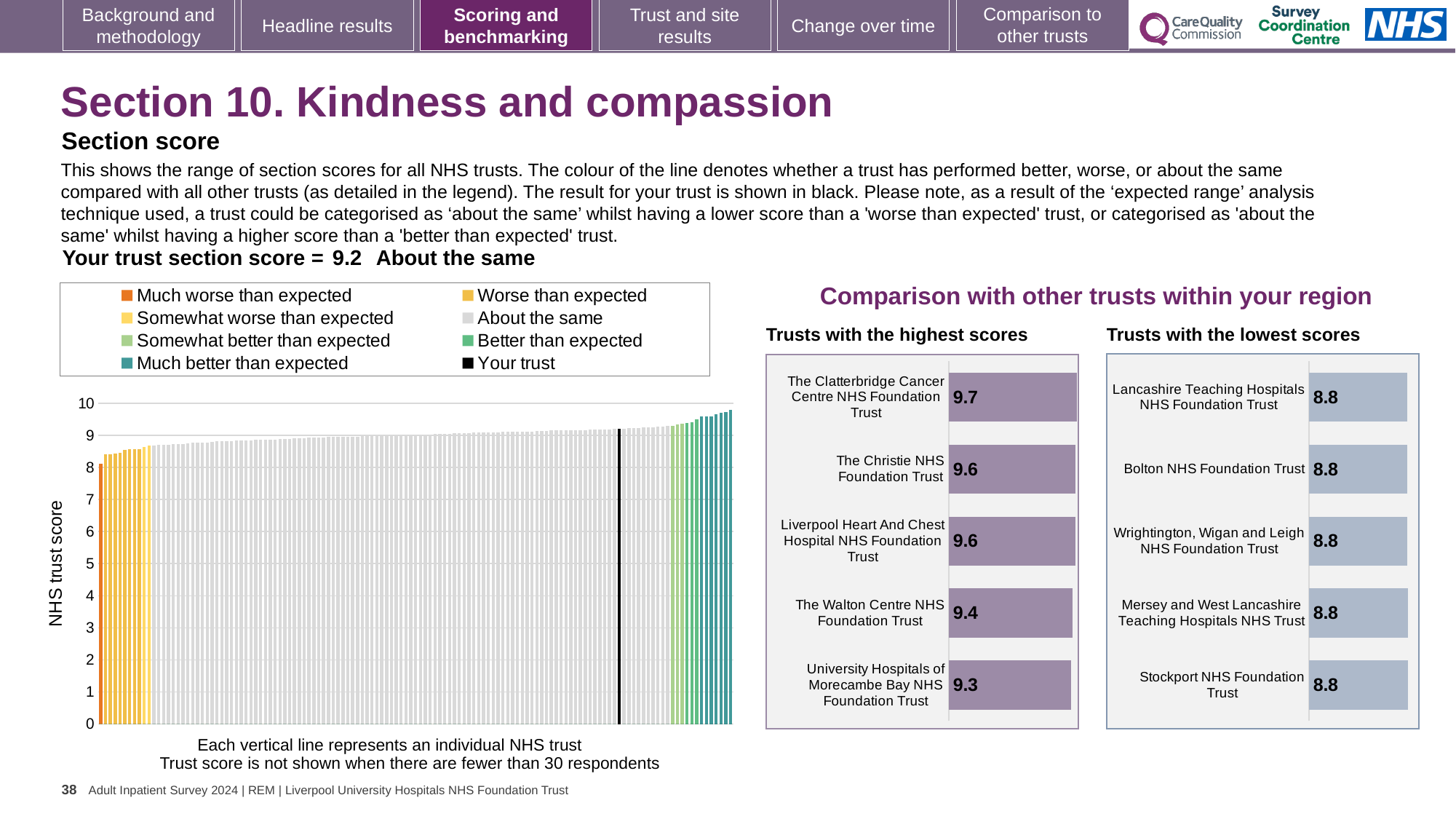
In the large chart on the left, is the value of the leftmost (orange) bar greater or less than 9? less In the 'Trusts with the lowest scores' chart, what is the score for Stockport NHS Foundation Trust? 8.8 How many entries does the legend above the large chart on the left list? 8 In the large chart on the left, what is the label on the vertical axis? NHS trust score In the 'Trusts with the highest scores' chart, what is the score for The Walton Centre NHS Foundation Trust? 9.4 In the large chart on the left, do the trust scores rise or fall from left to right? rise In the 'Trusts with the highest scores' chart, what is the difference between the scores of The Clatterbridge Cancer Centre NHS Foundation Trust and University Hospitals of Morecambe Bay NHS Foundation Trust? 0.4 According to the slide, what is your trust's section score for Kindness and compassion? 9.2 In the 'Trusts with the highest scores' chart, which trust has the highest score? The Clatterbridge Cancer Centre NHS Foundation Trust In the 'Trusts with the highest scores' chart, which trust has the lowest score? University Hospitals of Morecambe Bay NHS Foundation Trust How many trusts are shown in the 'Trusts with the lowest scores' chart? 5 What kind of chart is the large chart on the left showing NHS trust scores? bar chart